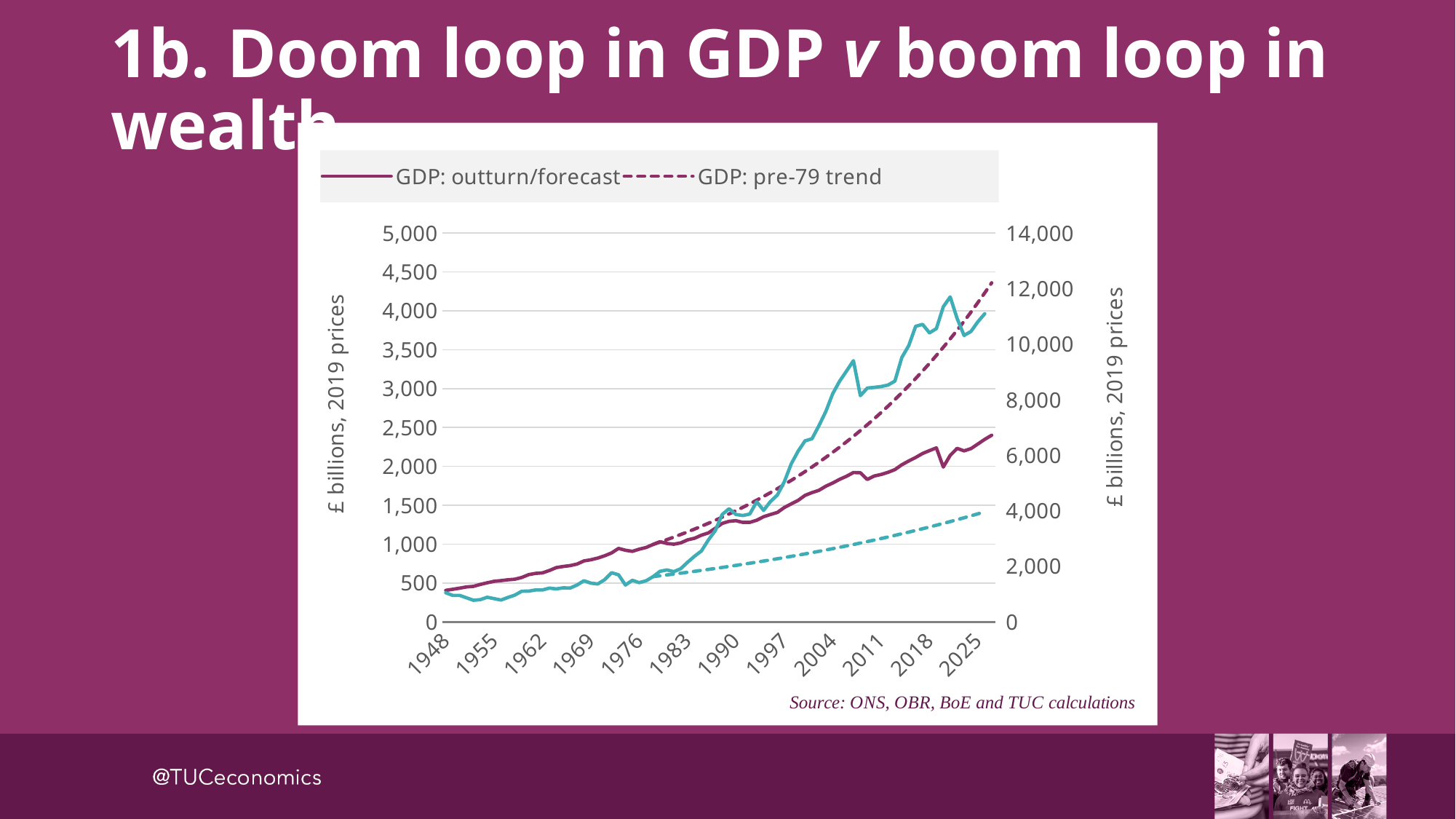
Is the value of GDP: outturn/forecast in 1948 greater or less than 500 on the left axis? less Is the value of GDP: outturn/forecast in 2025 greater or less than 2,000 on the left axis? greater Does the GDP: outturn/forecast line rise or fall from 1948 to 2025? Rise How many series does the chart's legend list? 2 What kind of chart is shown on the slide? Line chart How many year labels are shown on the x axis? 12 What is the label on the left vertical axis? £ billions, 2019 prices What is the highest tick value shown on the right vertical axis? 14,000 In 2025, which is higher: GDP: pre-79 trend or GDP: outturn/forecast? GDP: pre-79 trend What are the two series named in the legend? GDP: outturn/forecast and GDP: pre-79 trend Is the value of GDP: outturn/forecast in 1990 greater or less than 1,500 on the left axis? less